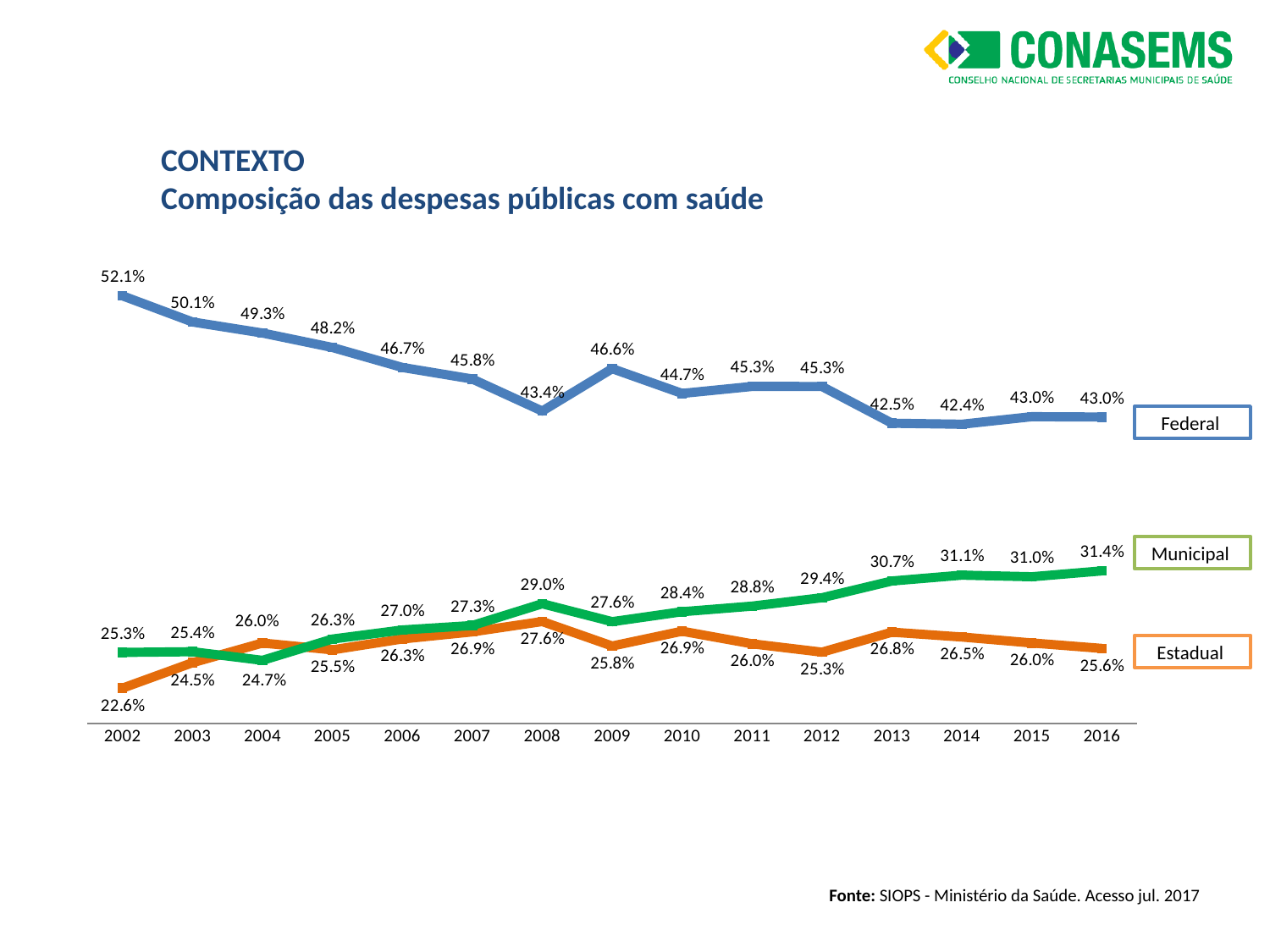
How many series does the legend list? 3 Does the Federal series generally rise or fall from 2002 to 2016? fall What is the Municipal value in 2016? 31.4% What type of chart is shown on the slide? line chart What is the Federal value in 2002? 52.1% How many years are shown on the x axis? 15 What is the difference between the Federal value in 2002 and in 2016? 9.1% In which year is the Estadual value lowest? 2002 What is the title of the chart? Composição das despesas públicas com saúde Which is larger in 2013, the Municipal value or the Estadual value? Municipal What is the Estadual value in 2012? 25.3% In which year is the Federal value highest? 2002